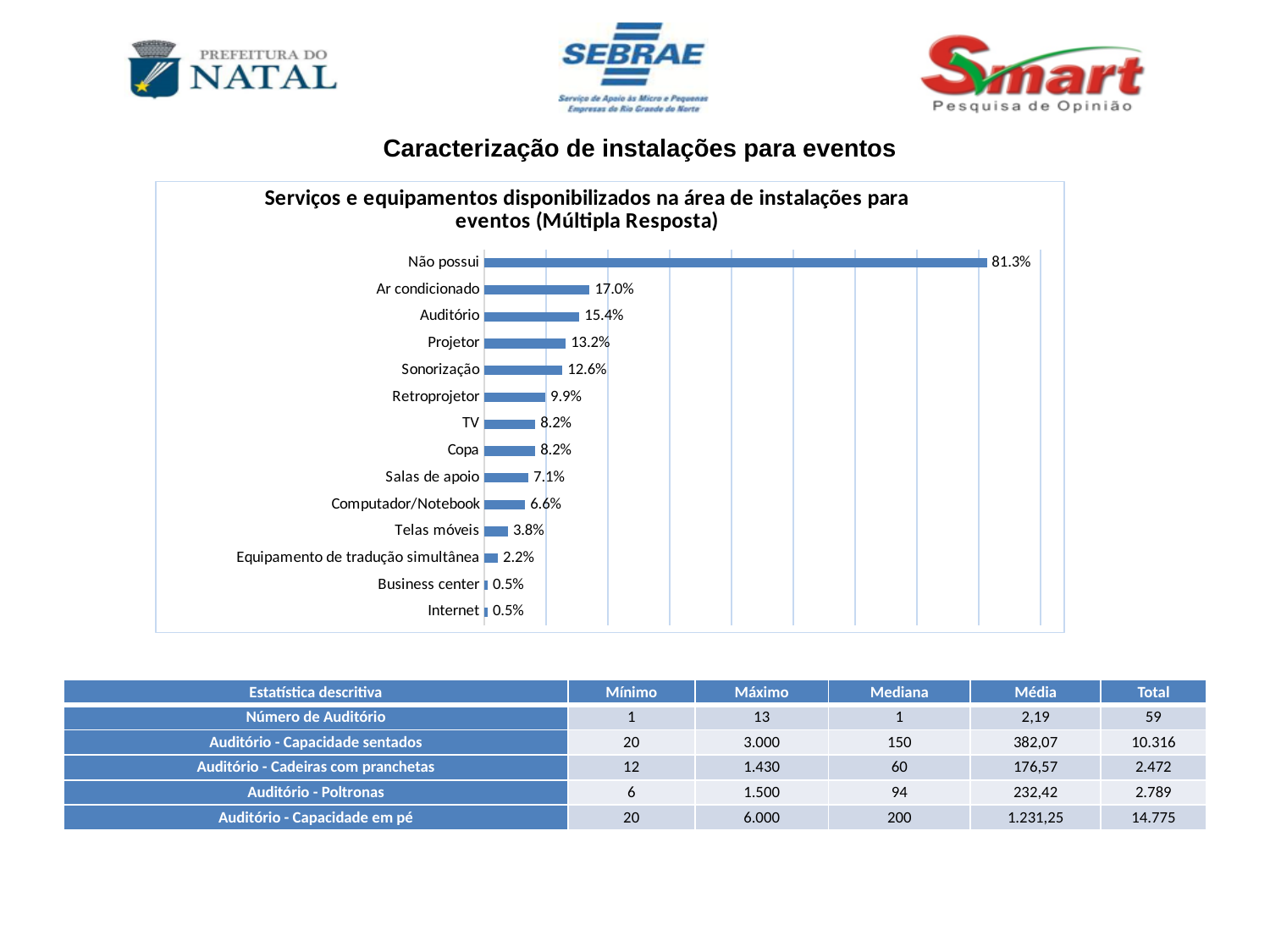
Which category has the highest value in the chart? Não possui What is the difference between the values for Não possui and Ar condicionado? 64.3% What is the value for Retroprojetor in the chart? 9.9% Which is larger, the value for Telas móveis or the value for Computador/Notebook? Computador/Notebook Which is larger, the value for Sonorização or the value for Salas de apoio? Sonorização What kind of chart is shown on the slide? Bar chart What is the title of the chart? Serviços e equipamentos disponibilizados na área de instalações para eventos (Múltipla Resposta) What is the value for Ar condicionado in the chart? 17.0% What is the difference between the values for Auditório and Projetor? 2.2% How many categories are shown in the chart? 14 What is the value for Copa in the chart? 8.2% What is the value for Equipamento de tradução simultânea in the chart? 2.2%